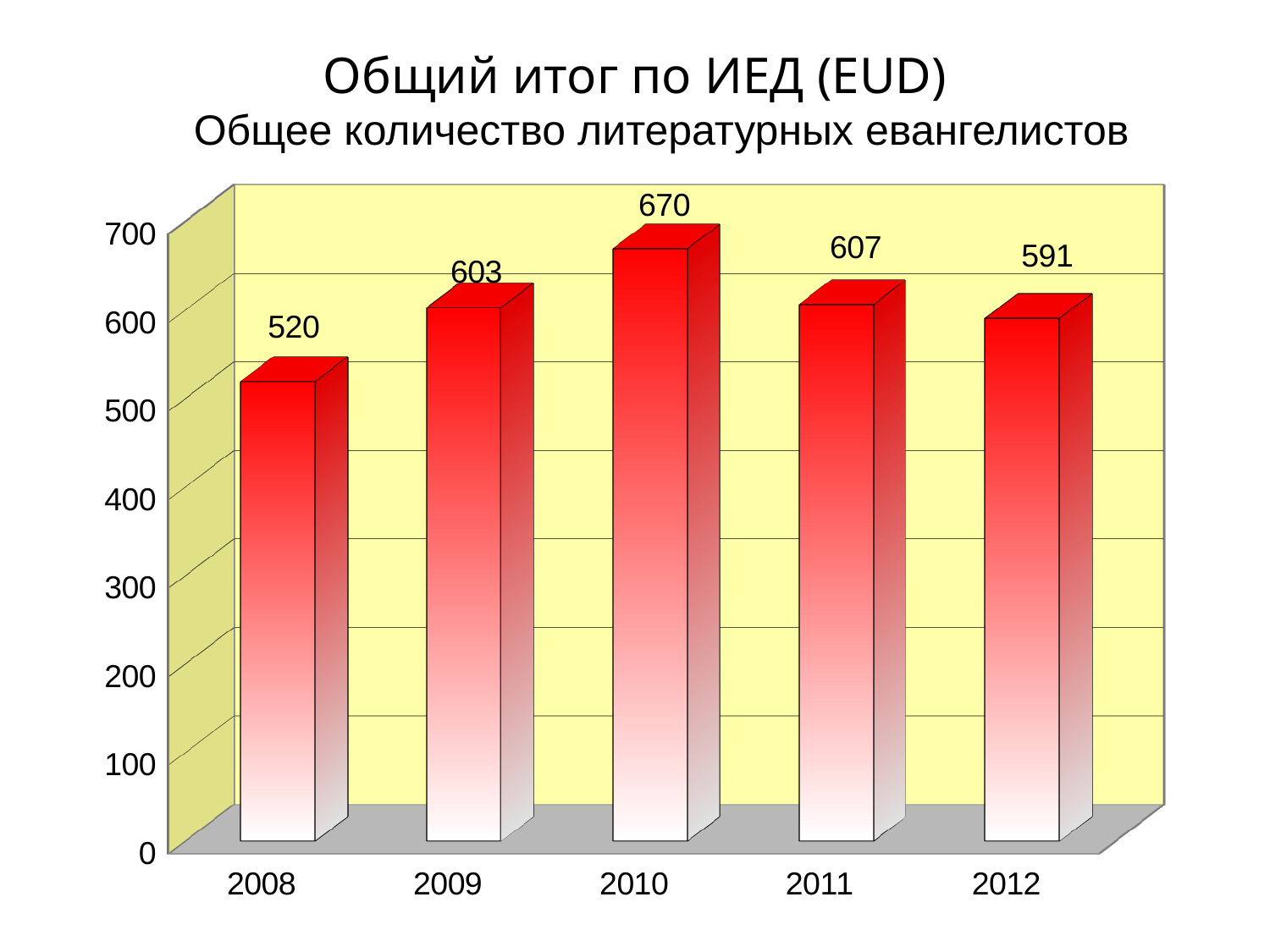
What is the value for 2010? 670 What is the value for 2008? 520 How many years are shown on the x axis? 5 Which year has the lowest value? 2008 What is the difference between the values for 2011 and 2012? 16 Do the values rise or fall from 2010 to 2012? fall Which is larger, the value for 2009 or the value for 2011? 2011 What kind of chart is shown on the slide? bar chart Which year has the highest value? 2010 What is the difference between the values for 2010 and 2008? 150 What is the value for 2012? 591 Is the value for 2012 greater or less than 500? greater